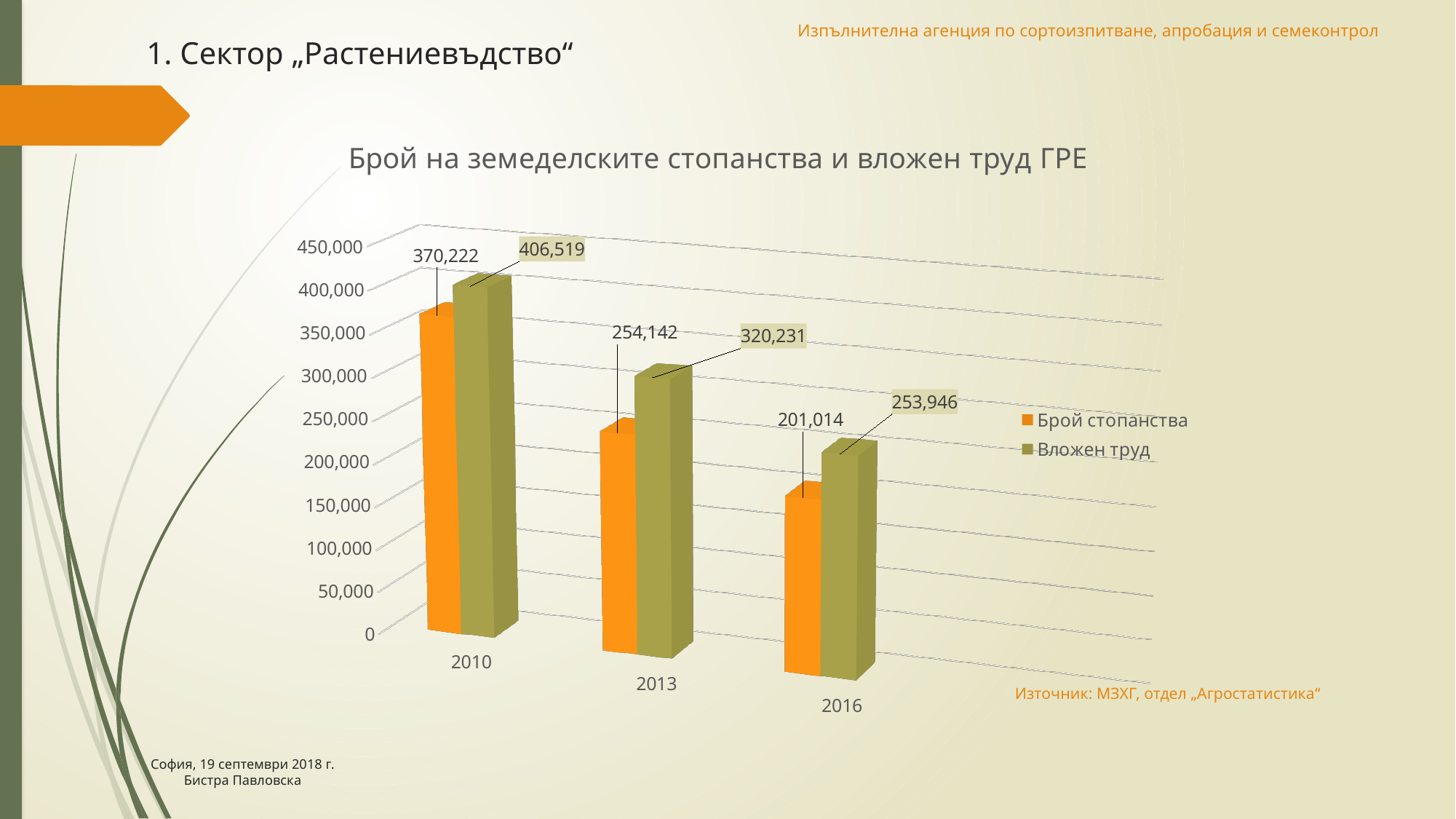
Which year has the lowest value for Брой стопанства? 2016 What is the value of Брой стопанства for 2010? 370,222 How many years are shown on the x axis? 3 What is the difference between Вложен труд and Брой стопанства in 2013? 66,089 Do the values for Брой стопанства rise or fall from 2010 to 2016? fall How many series does the legend list? 2 What is the difference between Брой стопанства in 2010 and in 2016? 169,208 What is the value of Вложен труд for 2013? 320,231 What is the value of Вложен труд for 2016? 253,946 Which year has the highest value for Вложен труд? 2010 What is the value of Брой стопанства for 2016? 201,014 Which is larger in 2016: Брой стопанства or Вложен труд? Вложен труд